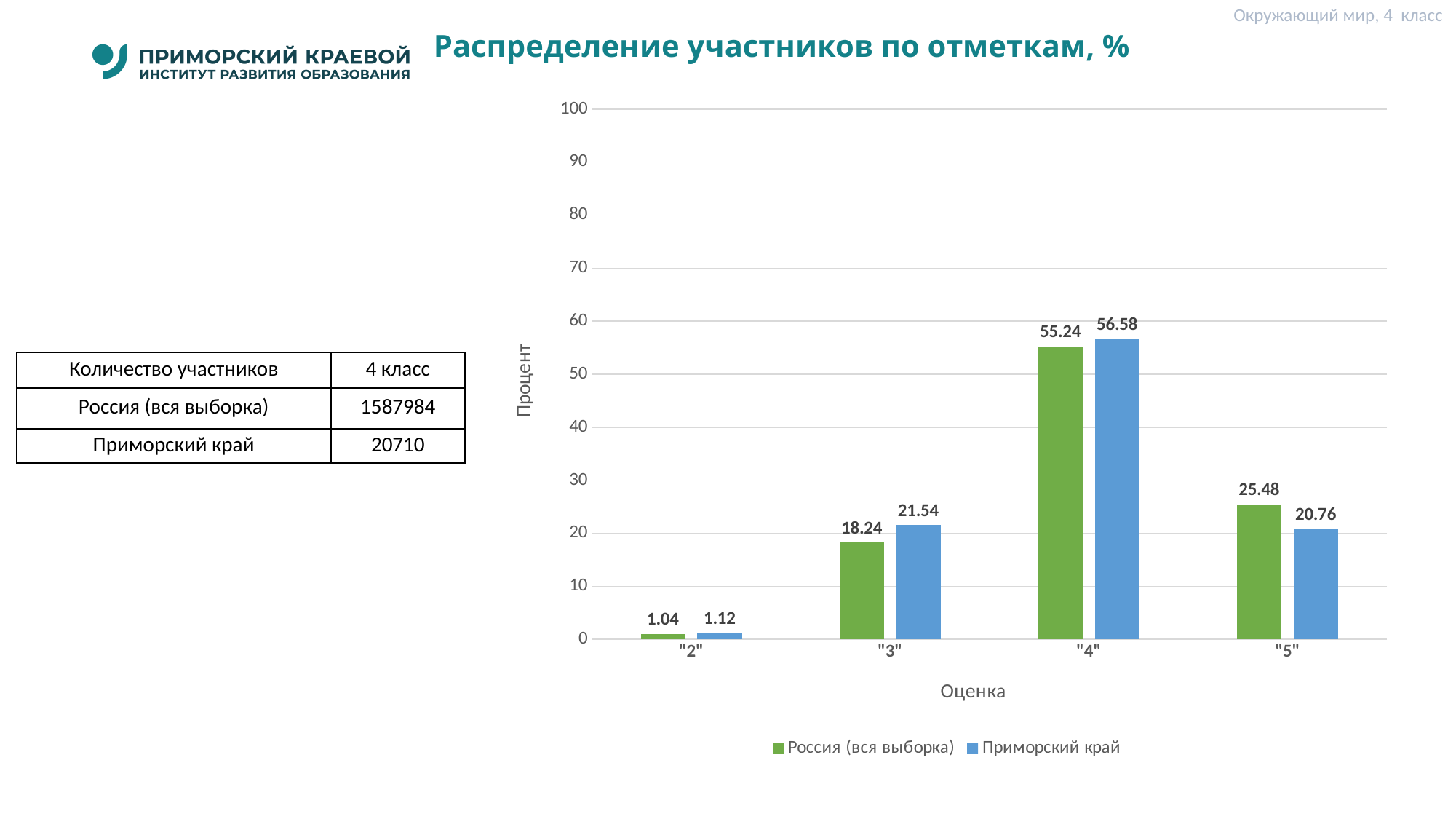
What is the title of the chart? Распределение участников по отметкам, % Which grade has the lowest value for Россия (вся выборка)? "2" What kind of chart is shown on the slide? bar chart What is the difference between Россия (вся выборка) and Приморский край at grade "5"? 4.72 Is the value for Россия (вся выборка) at grade "4" greater or less than 50? greater At grade "3", which series has the larger value, Россия (вся выборка) or Приморский край? Приморский край What is the value for Россия (вся выборка) at grade "3"? 18.24 How many grade categories are shown on the x axis? 4 Which grade has the highest value for Приморский край? "4" How many series does the legend list? 2 What is the value for Россия (вся выборка) at grade "2"? 1.04 What is the value for Приморский край at grade "4"? 56.58